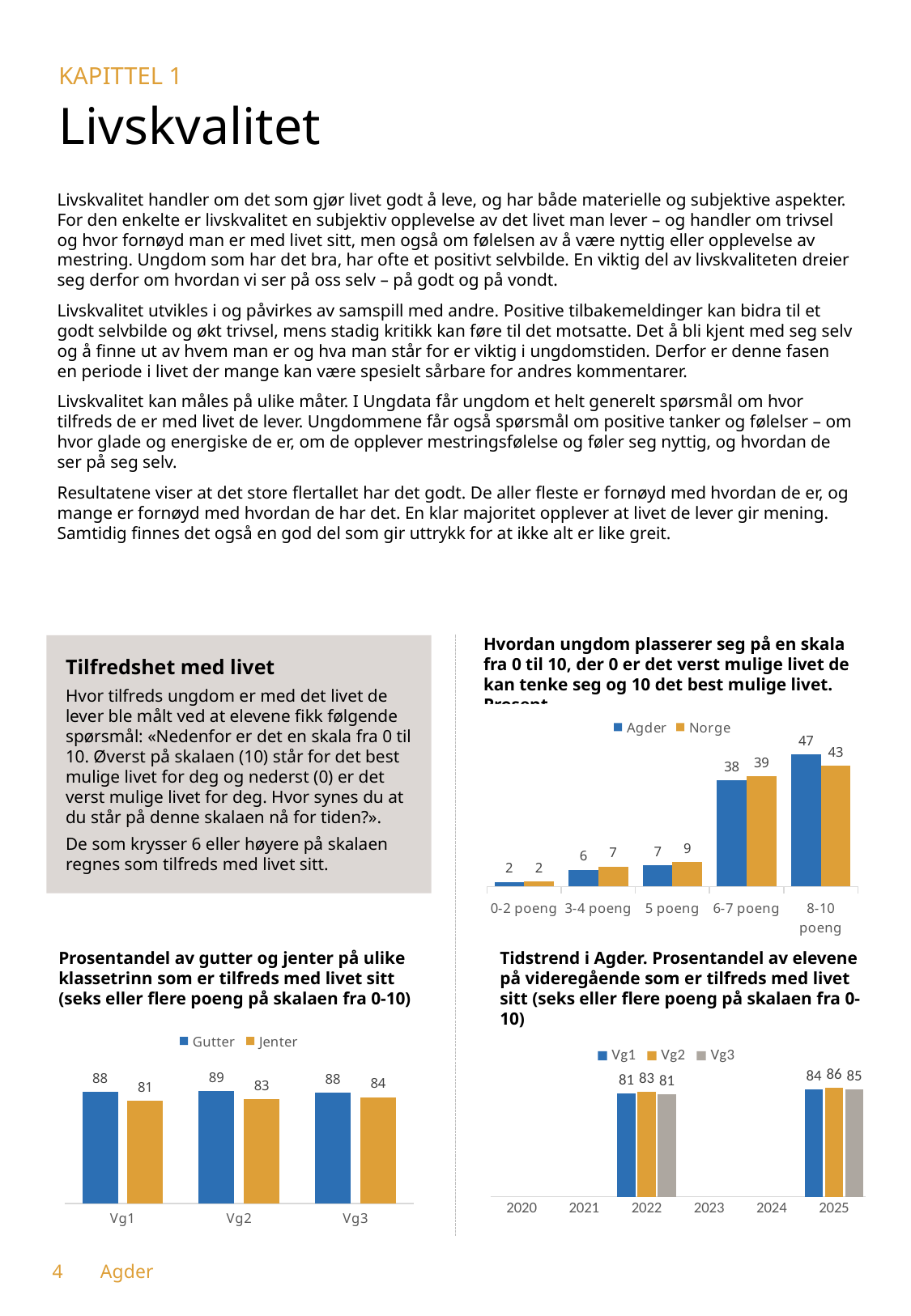
In the top-right chart (Hvordan ungdom plasserer seg på en skala fra 0 til 10), what is the value for Agder in the 8-10 poeng category? 47 In the bottom-left chart (Prosentandel av gutter og jenter på ulike klassetrinn), what kind of chart is it? Bar chart In the bottom-left chart (Prosentandel av gutter og jenter på ulike klassetrinn), what is the difference between Gutter and Jenter at Vg1? 7 In the bottom-left chart (Prosentandel av gutter og jenter på ulike klassetrinn), which is larger at Vg1, Gutter or Jenter? Gutter In the bottom-right chart (Tidstrend i Agder), how many series does the legend list? 3 In the top-right chart (Hvordan ungdom plasserer seg på en skala fra 0 til 10), what is the value for Norge in the 6-7 poeng category? 39 In the top-right chart (Hvordan ungdom plasserer seg på en skala fra 0 til 10), which category has the highest value for Agder? 8-10 poeng In the top-right chart (Hvordan ungdom plasserer seg på en skala fra 0 til 10), how many categories are shown on the x axis? 5 In the top-right chart (Hvordan ungdom plasserer seg på en skala fra 0 til 10), what is the difference between Agder and Norge in the 8-10 poeng category? 4 In the bottom-right chart (Tidstrend i Agder), what is the value for Vg2 in 2025? 86 In the bottom-left chart (Prosentandel av gutter og jenter på ulike klassetrinn), what is the value for Jenter at Vg2? 83 In the bottom-right chart (Tidstrend i Agder), does the value for Vg1 rise or fall from 2022 to 2025? Rise